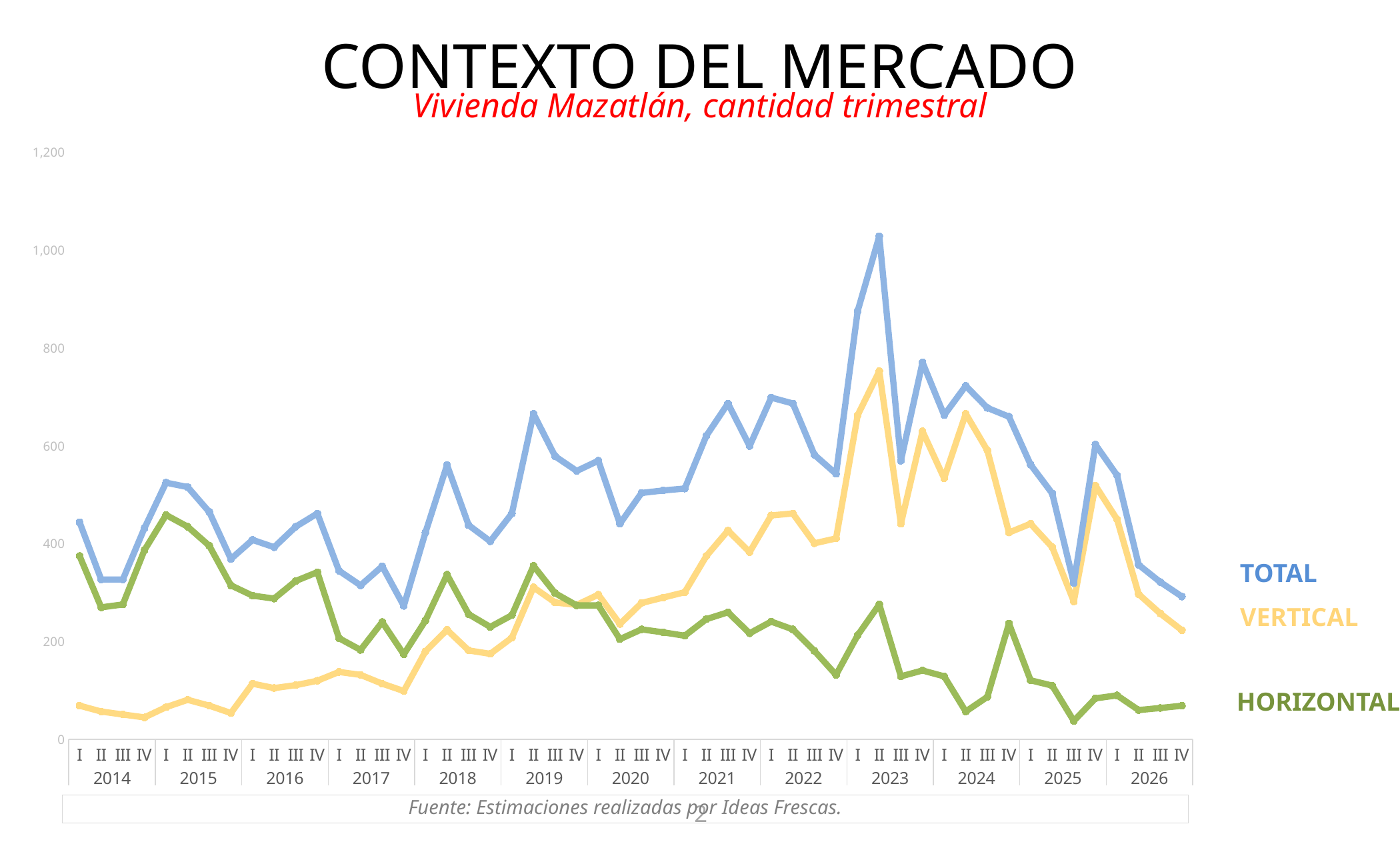
In quarter IV of 2026, which is larger, VERTICAL or HORIZONTAL? VERTICAL Does the VERTICAL series generally rise or fall from 2014 to 2023? rise What is the red subtitle of the chart? Vivienda Mazatlán, cantidad trimestral Is the VERTICAL value in quarter I of 2014 greater or less than 200? less How many series does the chart's legend list? 3 In quarter I of 2014, which is larger, VERTICAL or HORIZONTAL? HORIZONTAL In which year does the TOTAL series reach its highest value? 2023 Is the TOTAL value in quarter II of 2023 greater or less than 1,000? greater How many years are shown along the x axis of the chart? 13 Is the HORIZONTAL value in quarter I of 2015 greater or less than 400? greater What kind of chart is shown on the slide? line chart In which quarter of 2023 does the TOTAL series peak? II